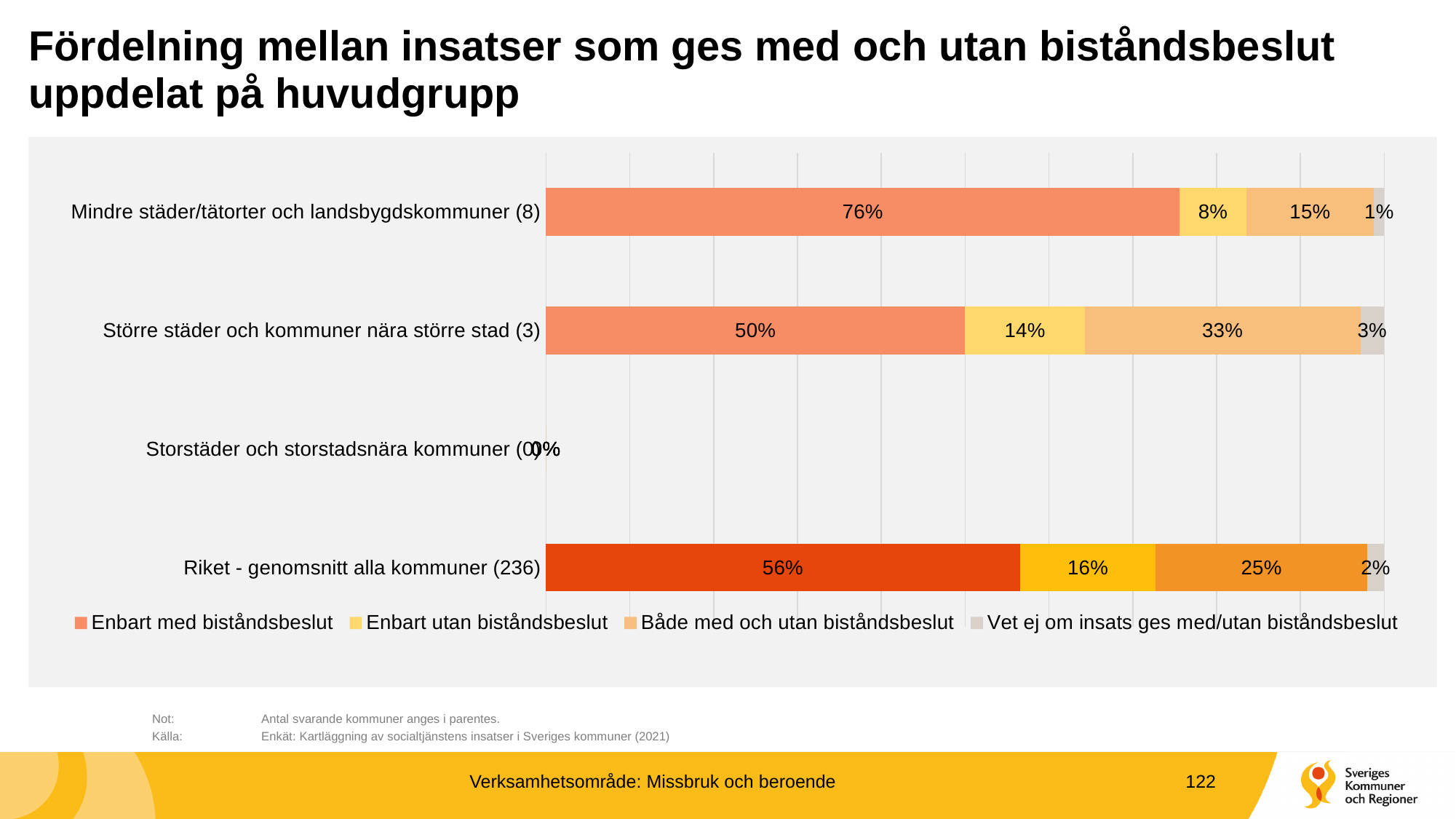
What kind of chart is shown on the slide? Stacked bar chart How many categories (huvudgrupper) are shown on the y axis? 4 Which has the larger value for 'Både med och utan biståndsbeslut': 'Större städer och kommuner nära större stad (3)' or 'Riket - genomsnitt alla kommuner (236)'? Större städer och kommuner nära större stad (3) What is the total of the stacked bar for 'Mindre städer/tätorter och landsbygdskommuner (8)'? 100% What is the value of 'Enbart med biståndsbeslut' for 'Mindre städer/tätorter och landsbygdskommuner (8)'? 76% What is the first entry in the chart's legend? Enbart med biståndsbeslut How many series does the legend list? 4 Which category has the highest value for 'Enbart med biståndsbeslut'? Mindre städer/tätorter och landsbygdskommuner (8) What is the value of 'Enbart utan biståndsbeslut' for 'Riket - genomsnitt alla kommuner (236)'? 16% What is the difference in 'Enbart med biståndsbeslut' between 'Mindre städer/tätorter och landsbygdskommuner (8)' and 'Riket - genomsnitt alla kommuner (236)'? 20 percentage points What is the value of 'Vet ej om insats ges med/utan biståndsbeslut' for 'Större städer och kommuner nära större stad (3)'? 3% What is the value of 'Både med och utan biståndsbeslut' for 'Större städer och kommuner nära större stad (3)'? 33%